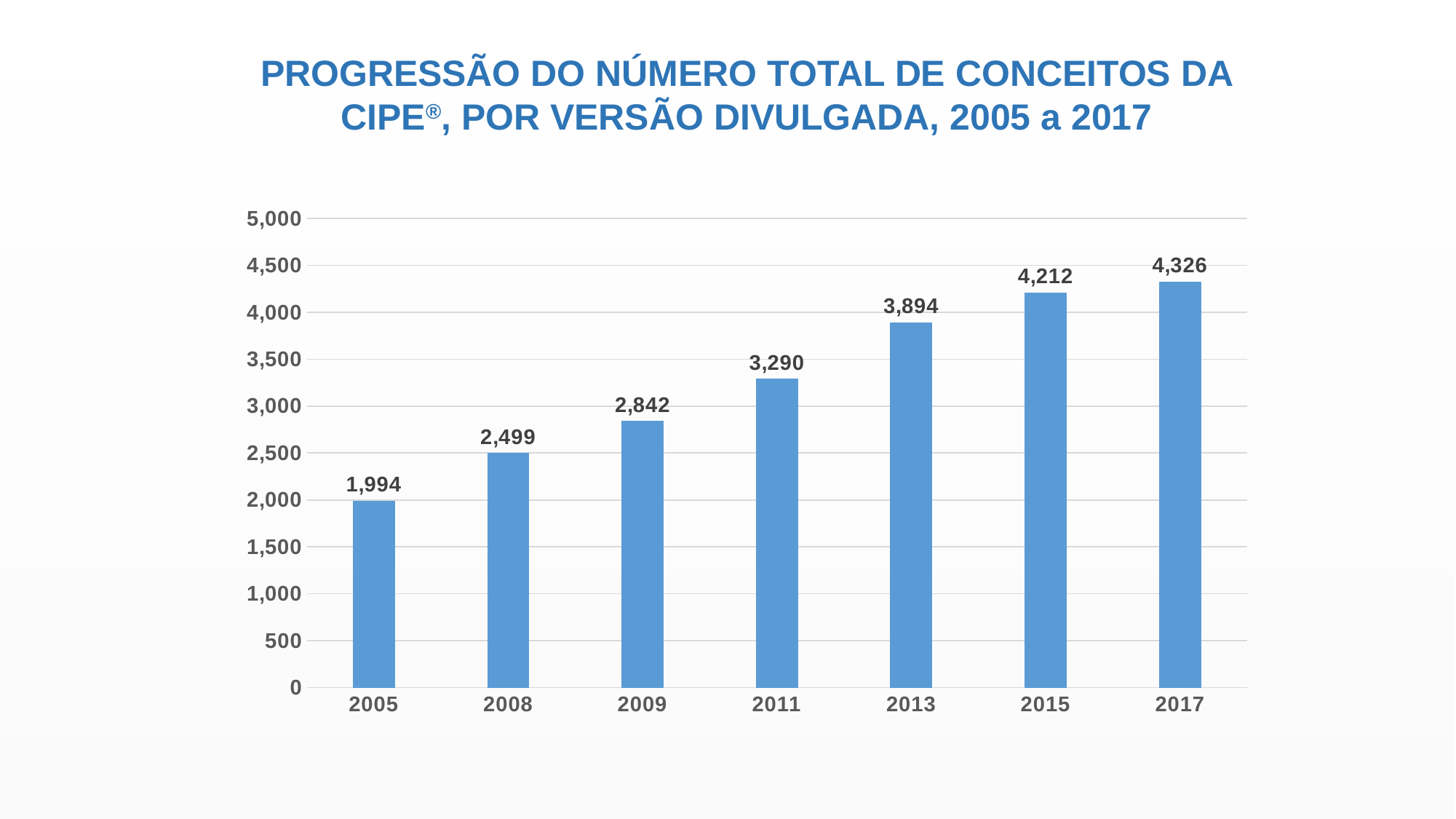
What is the value for 2005? 1,994 Which is larger, the value for 2009 or the value for 2008? 2009 Which year has the highest value? 2017 Do the values rise or fall from 2005 to 2017? rise What is the value for 2017? 4,326 What is the difference between the values for 2013 and 2005? 1,900 Is the value for 2013 greater or less than 3,500? greater What is the difference between the values for 2017 and 2015? 114 How many years are shown on the x axis? 7 What kind of chart is this? bar chart Which year has the lowest value? 2005 What is the value for 2011? 3,290